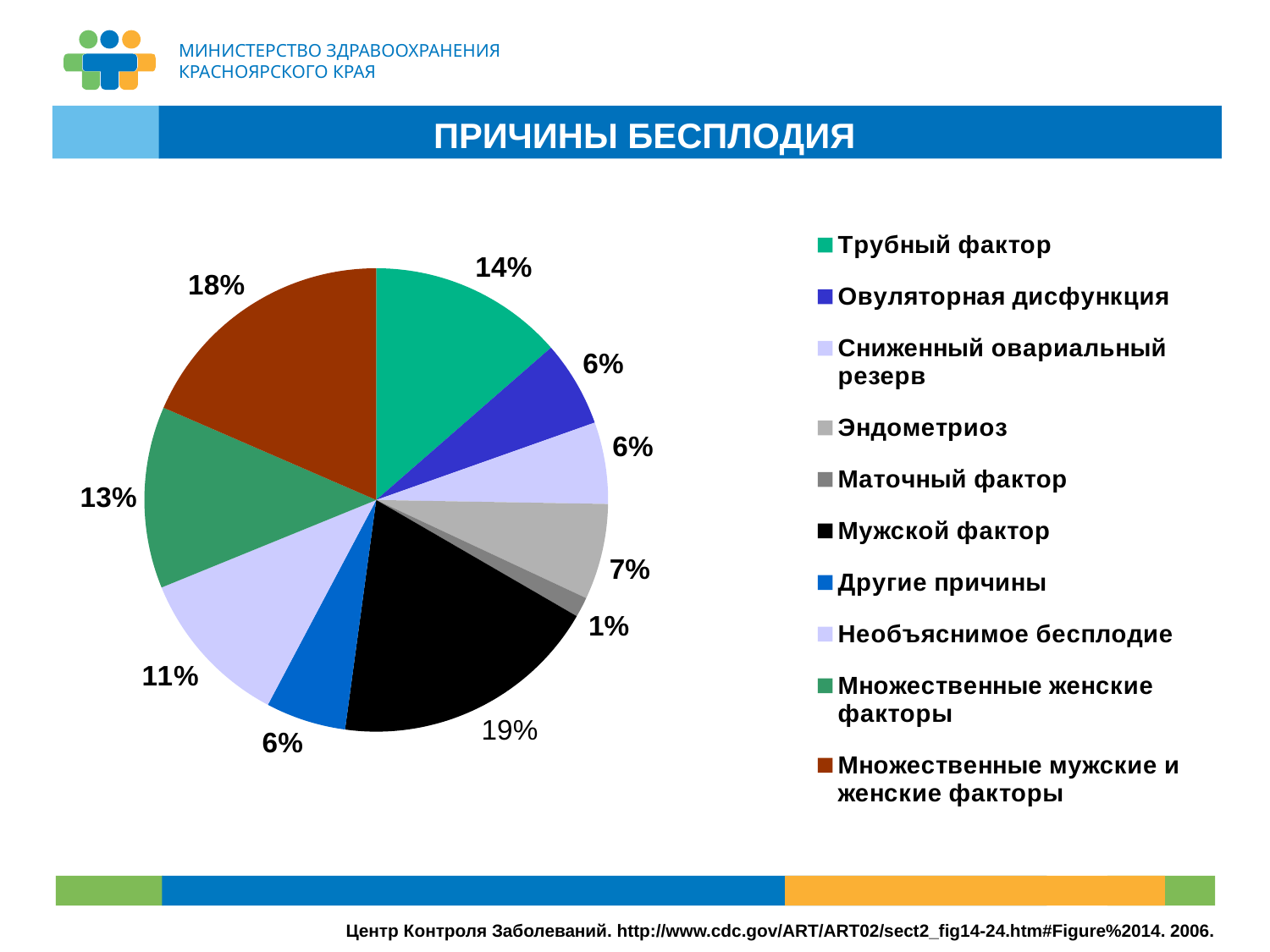
What colour is the slice for Мужской фактор? black What share of the pie is Необъяснимое бесплодие? 11% What share of the pie is Множественные мужские и женские факторы? 18% What kind of chart is shown on the slide? pie chart What share of the pie is Трубный фактор? 14% Which category has the largest slice of the pie? Мужской фактор How many categories does the legend list? 10 What is the difference between the shares of Мужской фактор and Трубный фактор? 5% Which category has the smallest slice of the pie? Маточный фактор What is the title of the chart? ПРИЧИНЫ БЕСПЛОДИЯ Which is larger, the share of Множественные женские факторы or the share of Эндометриоз? Множественные женские факторы